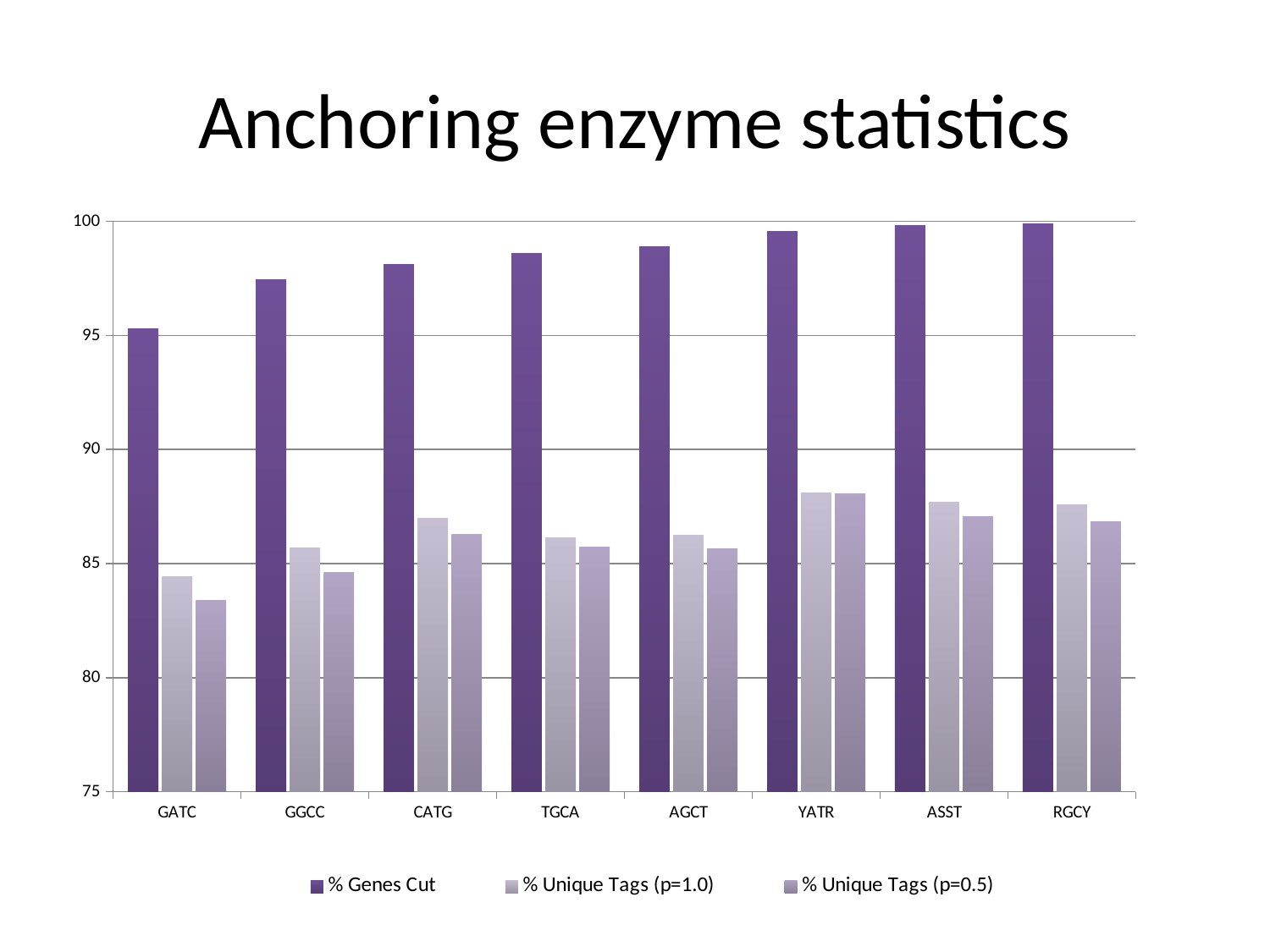
Is the % Unique Tags (p=1.0) value for CATG greater or less than 85? greater Which category has the lowest value for % Unique Tags (p=1.0)? GATC What kind of chart is shown on the slide? Bar chart What is the title of the chart? Anchoring enzyme statistics How many series does the legend list? 3 Is the % Unique Tags (p=0.5) value for GATC greater or less than 85? less Is the % Genes Cut value for GGCC greater or less than 95? greater Do the % Genes Cut values rise or fall from GATC to RGCY along the x axis? rise Which is larger: the % Genes Cut value for GATC or for GGCC? GGCC Which category has the lowest value for % Genes Cut? GATC How many enzyme categories are shown on the x axis? 8 Which category has the highest value for % Unique Tags (p=0.5)? YATR